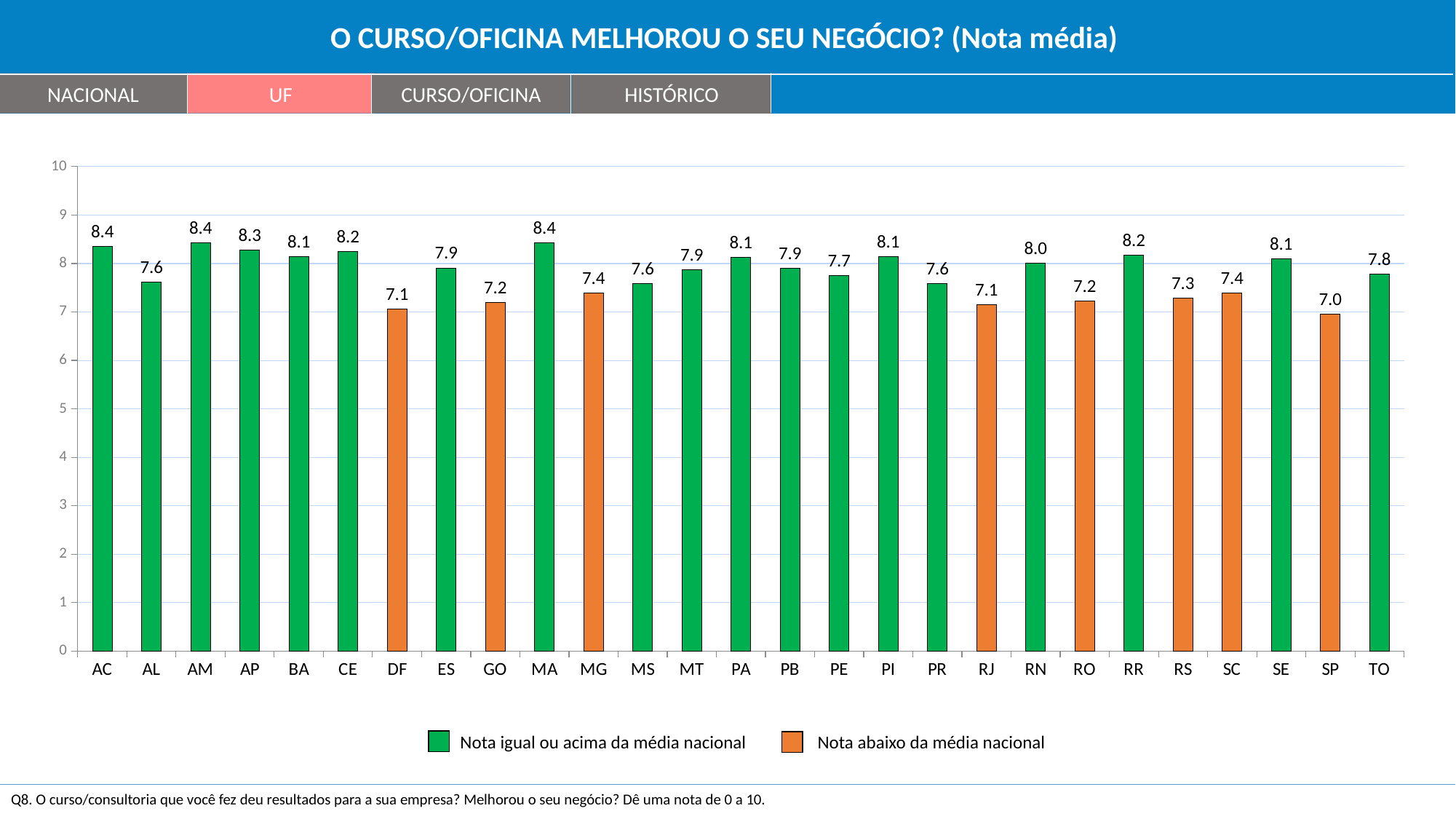
How many states (UF) are shown on the x axis? 27 Which state has the lowest average score? SP What type of chart is shown on the slide? Bar chart What is the difference between the scores for TO and RS? 0.5 How many entries does the legend list? 2 Which has a higher score, PE or RJ? PE What is the average score for SP? 7.0 What is the difference between the scores for AM and DF? 1.3 How many bars are coloured orange (Nota abaixo da média nacional)? 8 Which has a higher score, CE or GO? CE What is the average score for RN? 8.0 What is the average score for MA? 8.4